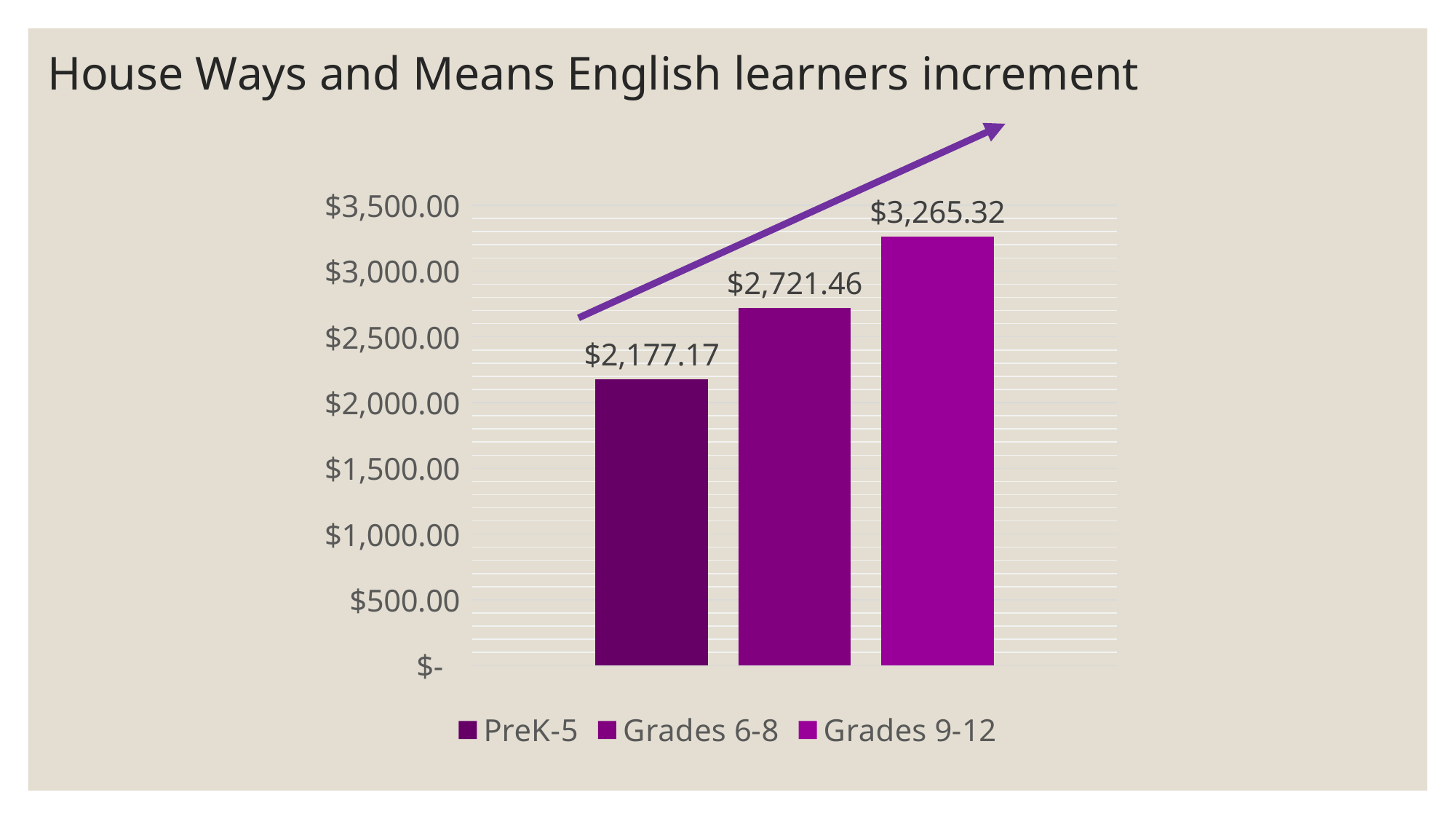
Which is larger, the value for Grades 6-8 or the value for PreK-5? Grades 6-8 What is the difference between the values for Grades 6-8 and PreK-5? $544.29 What is the value for Grades 6-8? $2,721.46 Which grade band has the lowest value? PreK-5 Which grade band has the highest value? Grades 9-12 What is the difference between the values for Grades 9-12 and Grades 6-8? $543.86 What is the value for Grades 9-12? $3,265.32 How many bars are shown in the chart? 3 What is the title of the chart? House Ways and Means English learners increment What is the value for PreK-5? $2,177.17 Is the value for Grades 9-12 greater or less than $3,000.00? greater What kind of chart is shown on the slide? bar chart